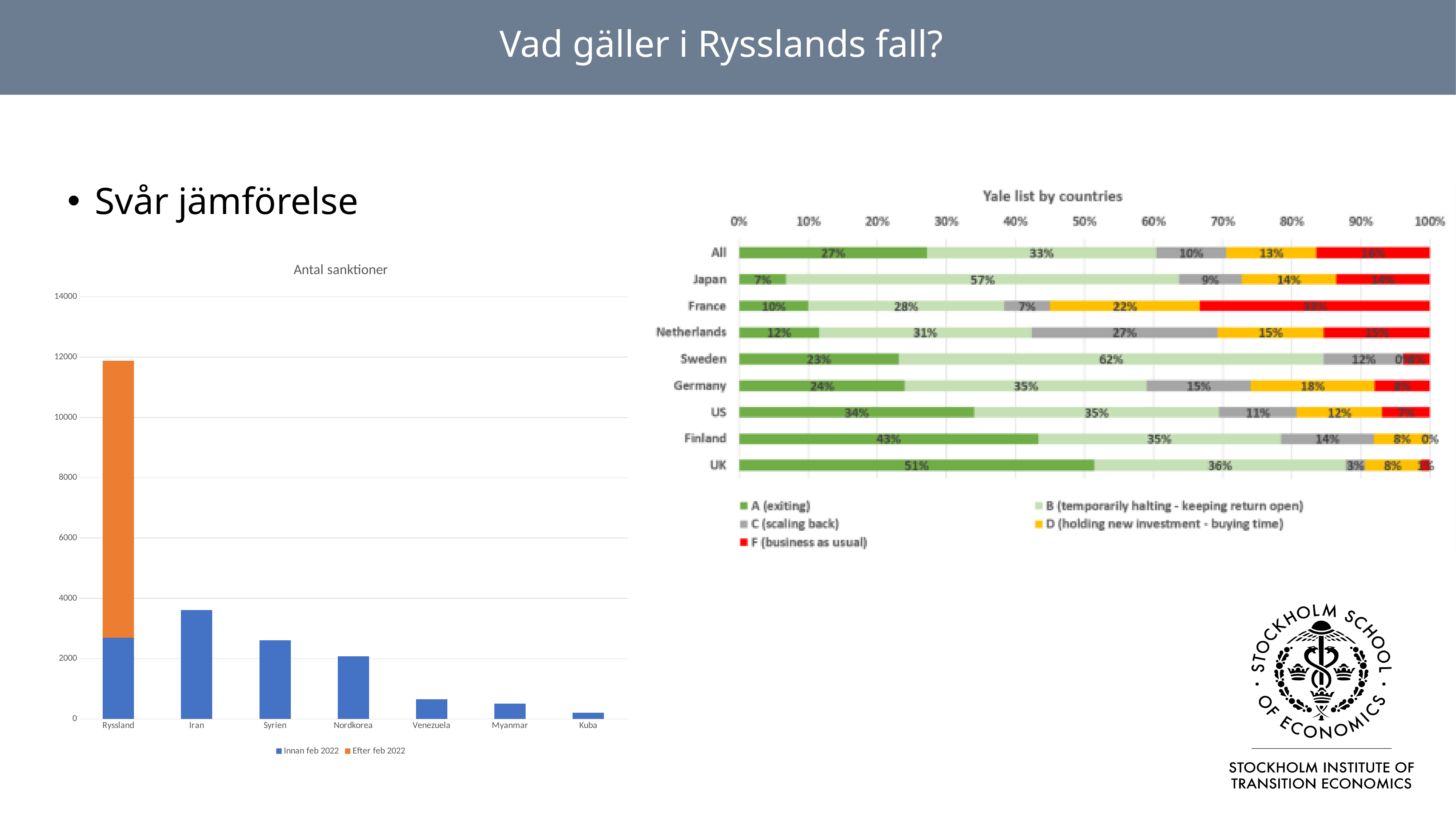
In the 'Antal sanktioner' chart, which country has the tallest bar? Ryssland In the 'Antal sanktioner' chart, which country has the shortest bar? Kuba In the 'Antal sanktioner' chart, is the total bar for Ryssland greater or less than 10000? greater In the 'Antal sanktioner' chart, how many countries are shown on the x axis? 7 In the 'Antal sanktioner' chart, how many series does the legend list? 2 In the 'Antal sanktioner' chart, is the value for Iran greater or less than 2000? greater In the 'Yale list by countries' chart, how many series does the legend list? 5 In the 'Yale list by countries' chart, which country has the lowest A (exiting) share? Japan In the 'Yale list by countries' chart, what is the A (exiting) share for the UK? 51% In the 'Antal sanktioner' chart, which country is the only one with an 'Efter feb 2022' segment? Ryssland In the 'Yale list by countries' chart, what is the B (temporarily halting) share for Sweden? 62% In the 'Yale list by countries' chart, what is the difference between the A (exiting) shares of Finland and the US? 9%